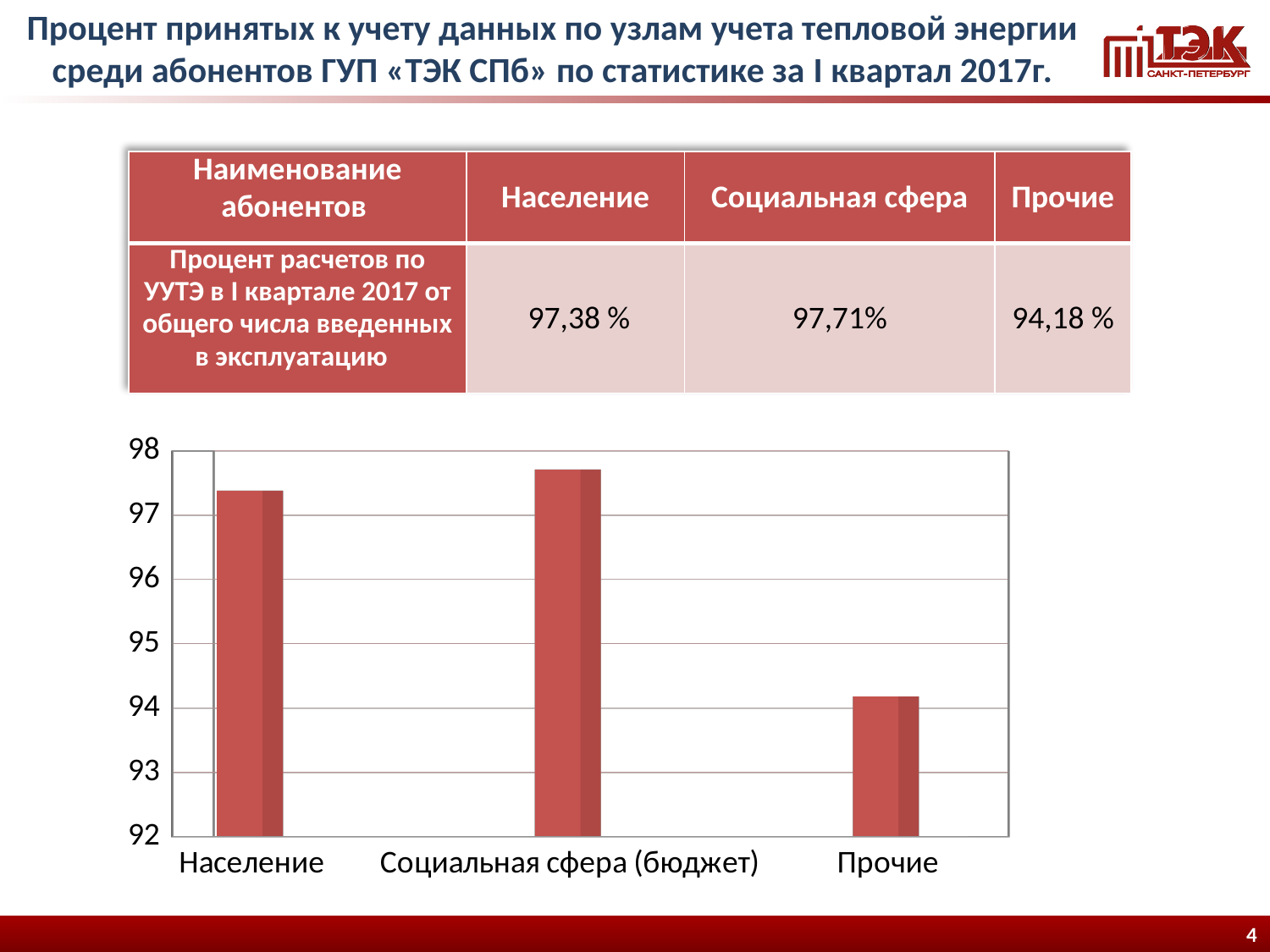
According to the table on the slide, what is the percentage for Прочие? 94,18 % According to the table on the slide, what is the percentage for Население? 97,38 % What is the lowest value shown on the chart's vertical axis? 92 How many categories are shown on the x axis of the chart? 3 Using the values in the table, what is the difference between Социальная сфера and Население? 0,33% Which category has the lowest bar in the chart? Прочие Which is larger, the value for Население or the value for Прочие? Население Is the value for Прочие greater or less than 95? less Which category has the highest bar in the chart? Социальная сфера (бюджет) Is the value for Население greater or less than 97? greater Is the value for Социальная сфера (бюджет) greater or less than 97? greater What kind of chart is shown on the slide? bar chart